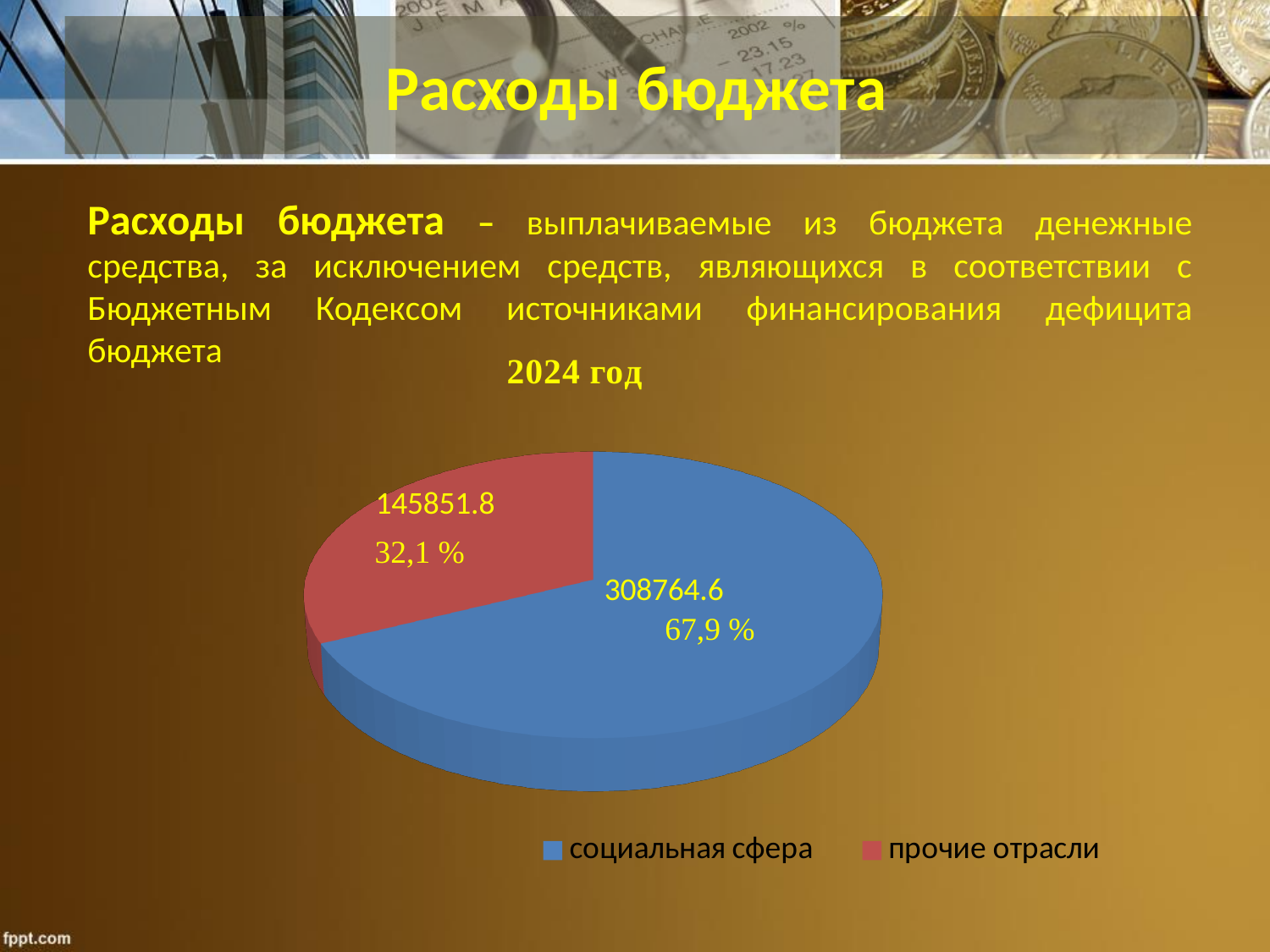
What year is shown in the chart title? 2024 год What kind of chart is shown on the slide? pie chart What is the value for социальная сфера? 308764.6 Which category has the largest slice? социальная сфера What is the value for прочие отрасли? 145851.8 Which category has the smallest slice? прочие отрасли Which colour represents прочие отрасли in the legend? red What share of the pie does прочие отрасли take? 32,1 % What share of the pie does социальная сфера take? 67,9 % How many slices does the pie chart have? 2 Which is larger, социальная сфера or прочие отрасли? социальная сфера What is the difference between the values for социальная сфера and прочие отрасли? 162912.8